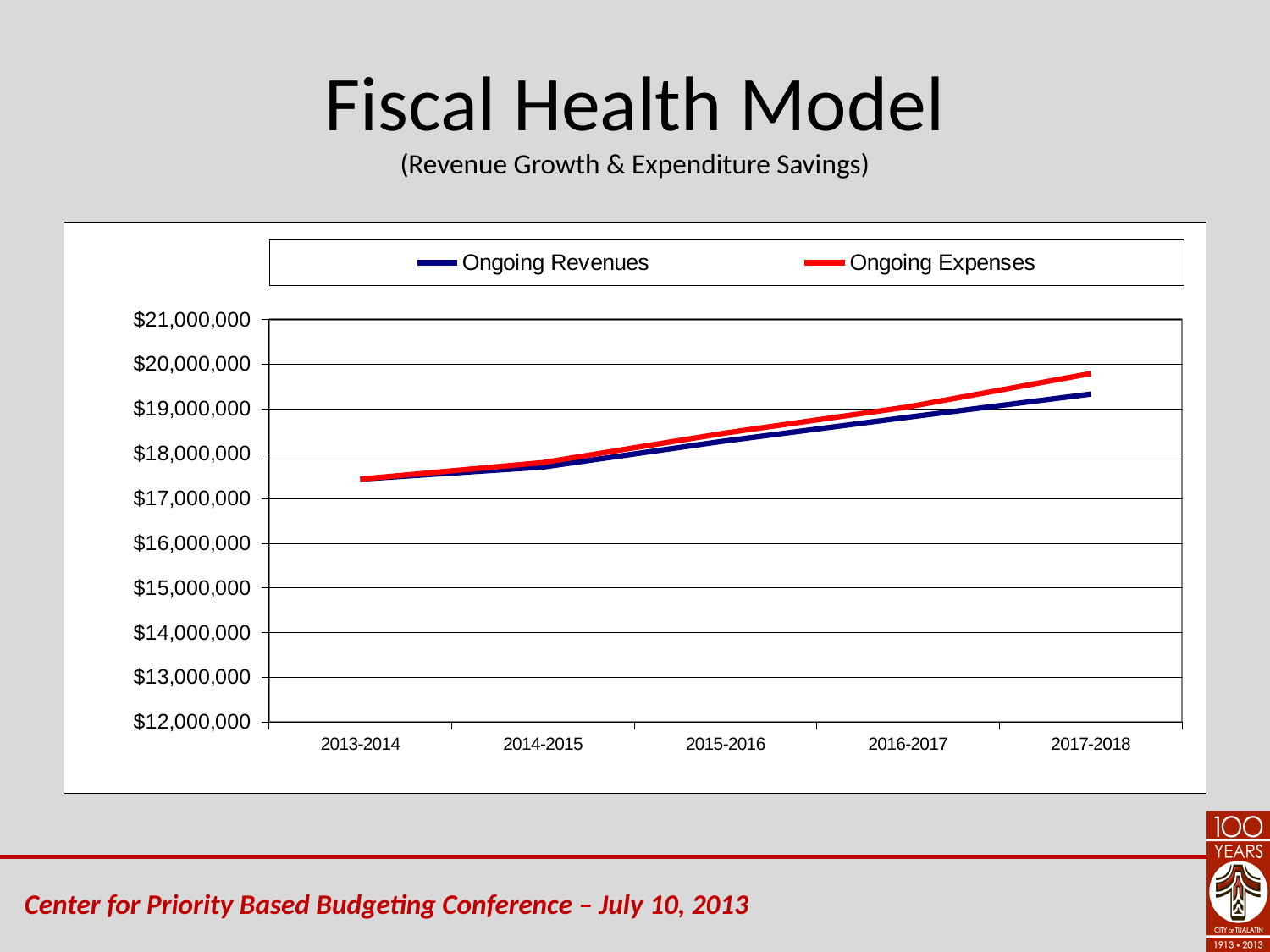
Do the Ongoing Revenues values rise or fall from 2013-2014 to 2017-2018? Rise Do the Ongoing Expenses values rise or fall across the fiscal years? Rise Is the value for Ongoing Expenses in 2017-2018 greater or less than $19,000,000? greater In which fiscal year is Ongoing Revenues lowest? 2013-2014 How many fiscal years are plotted along the x axis? 5 How many series does the legend list? 2 What kind of chart is shown on the slide? Line chart Is the value for Ongoing Revenues in 2013-2014 greater or less than $18,000,000? less In which fiscal year is Ongoing Expenses highest? 2017-2018 In 2017-2018, which is larger: Ongoing Revenues or Ongoing Expenses? Ongoing Expenses Which series is drawn in red? Ongoing Expenses What is the subtitle shown under the chart title 'Fiscal Health Model'? (Revenue Growth & Expenditure Savings)